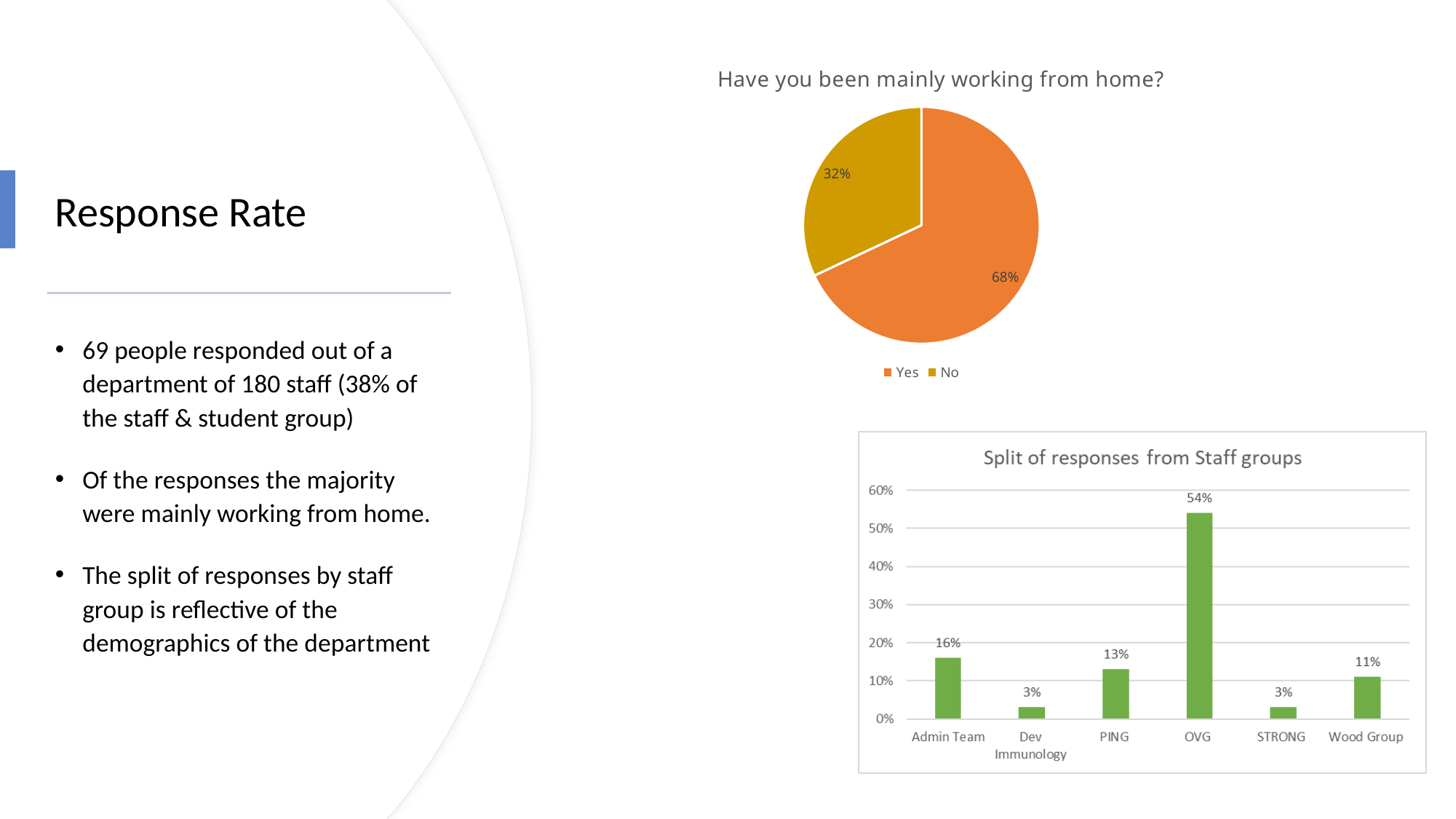
In the 'Split of responses from Staff groups' chart, which staff group has the highest value? OVG What kind of chart is 'Split of responses from Staff groups'? bar chart In the 'Have you been mainly working from home?' chart, what share of responses is 'No'? 32% In the 'Split of responses from Staff groups' chart, what is the difference between OVG and PING? 41% In the 'Split of responses from Staff groups' chart, how many staff groups are shown on the x axis? 6 In the 'Split of responses from Staff groups' chart, what is the value for Wood Group? 11% In the 'Have you been mainly working from home?' chart, how many entries does the legend list? 2 In the 'Split of responses from Staff groups' chart, which is larger, Admin Team or Wood Group? Admin Team What kind of chart is 'Have you been mainly working from home?'? pie chart In the 'Split of responses from Staff groups' chart, what is the value for OVG? 54% In the 'Split of responses from Staff groups' chart, what is the value for Admin Team? 16% In the 'Have you been mainly working from home?' chart, what share of responses is 'Yes'? 68%